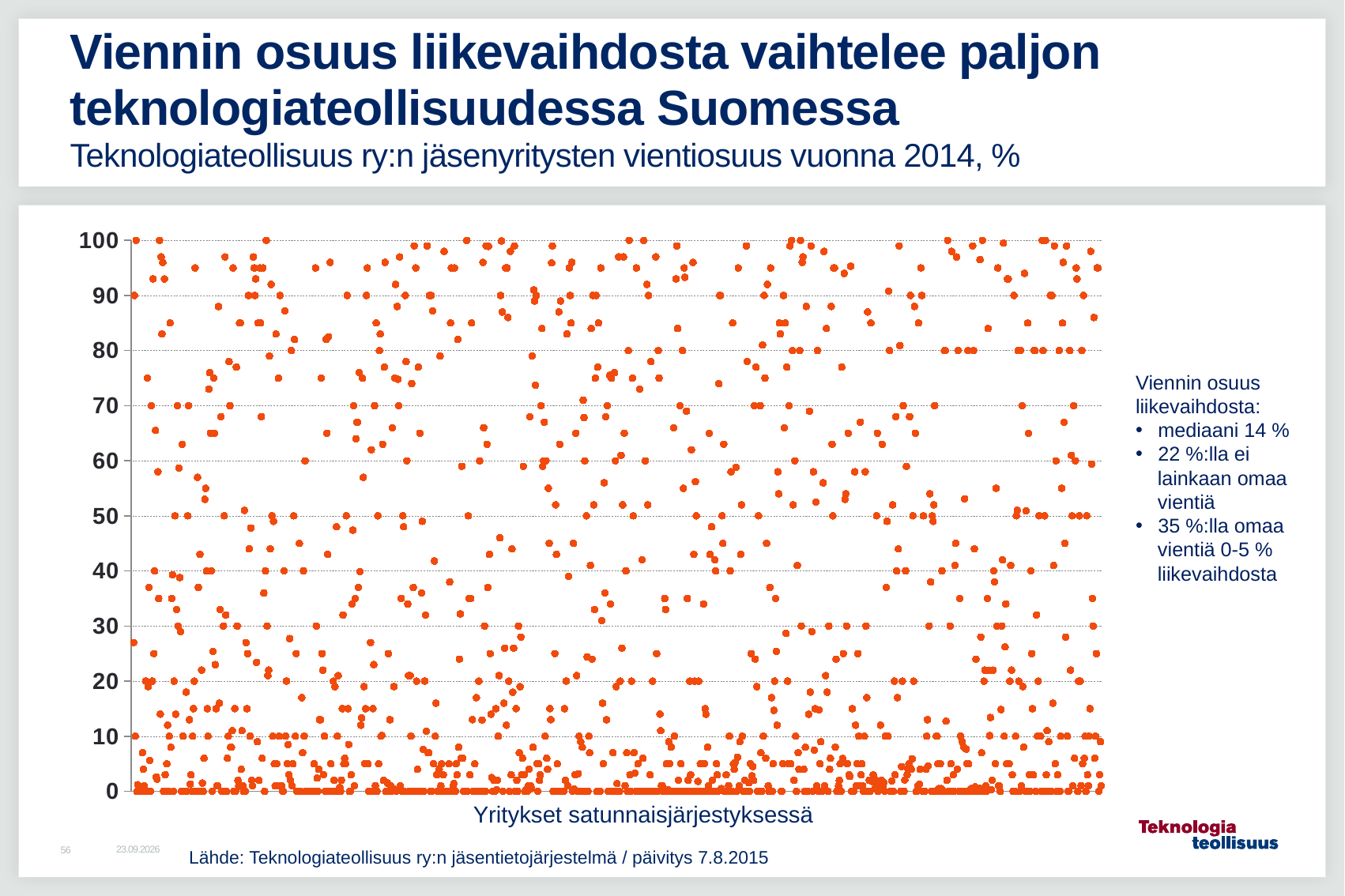
According to the text beside the chart, what is the median export share of turnover? 14 % What is the label on the x axis of the chart? Yritykset satunnaisjärjestyksessä According to the text beside the chart, what percentage of companies have exports of 0-5 % of turnover? 35 % What kind of chart is shown on the slide? scatter chart Which year does the chart's export share data refer to? 2014 According to the text beside the chart, what percentage of companies have no exports at all? 22 % What colour are the data points in the chart? orange